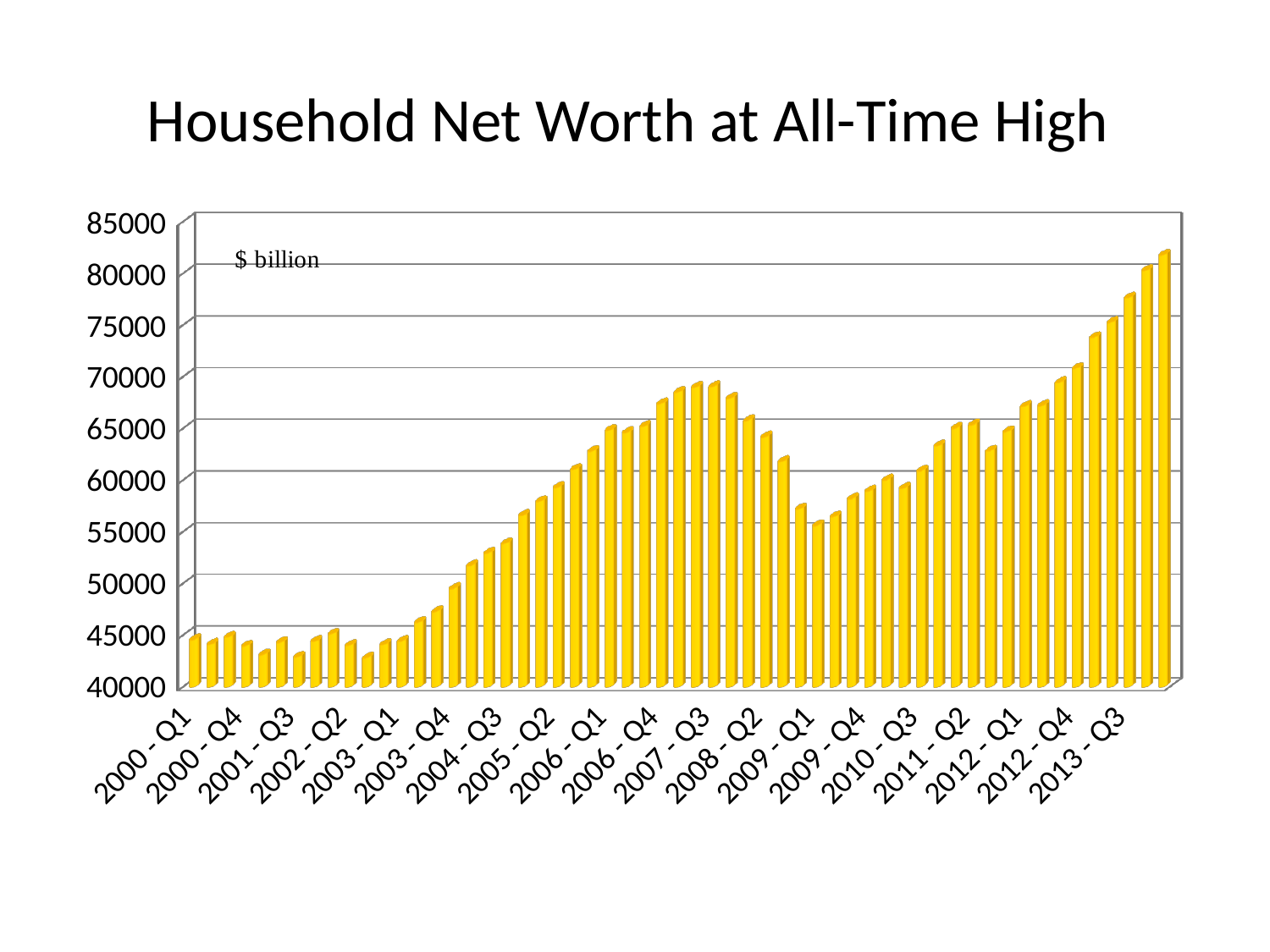
Do the values rise or fall between 2007 - Q3 and 2009 - Q1? fall What kind of chart is shown on the slide? bar chart Which is larger, the value for 2013 - Q3 or the value for 2007 - Q3? 2013 - Q3 What is the title of the chart? Household Net Worth at All-Time High Is the value for 2013 - Q3 greater or less than 75000? greater Is the value for 2009 - Q1 greater or less than 60000? less Is the value for 2012 - Q1 greater or less than 65000? greater What unit is indicated on the chart for the plotted values? $ billion Which is larger, the value for 2007 - Q3 or the value for 2009 - Q1? 2007 - Q3